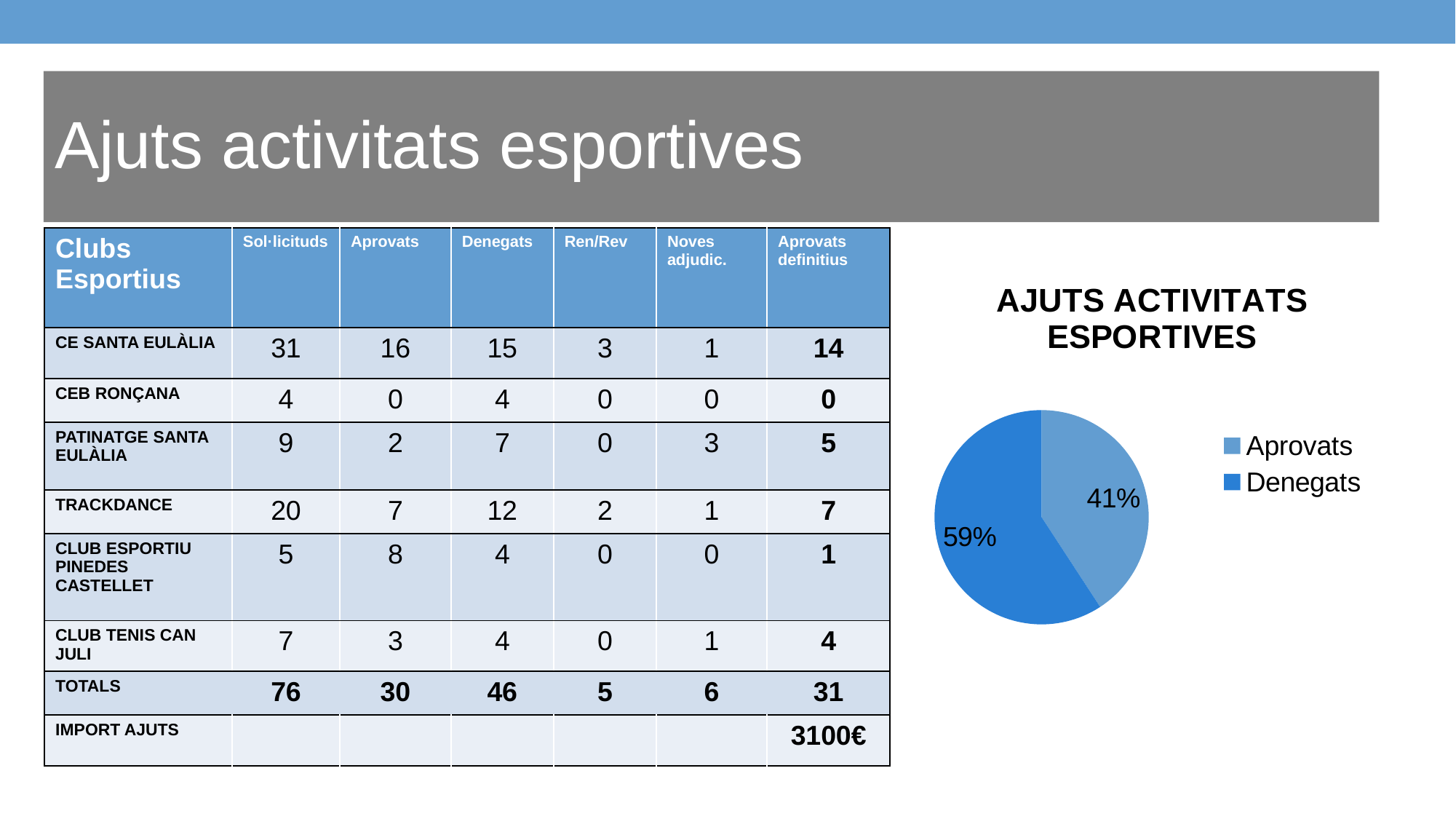
Which slice of the pie chart is the smallest? Aprovats What share of the pie does Aprovats represent? 41% How many slices does the pie chart have? 2 What is the title of the chart? AJUTS ACTIVITATS ESPORTIVES What type of chart is shown on the slide? pie chart Which slice of the pie chart is the largest? Denegats Which legend entry is shown in the lighter blue colour? Aprovats Is the share for Aprovats greater or less than 50%? less Which is larger in the pie chart, Aprovats or Denegats? Denegats How many entries does the chart legend list? 2 What share of the pie does Denegats represent? 59% What is the difference in percentage points between the Denegats and Aprovats slices? 18